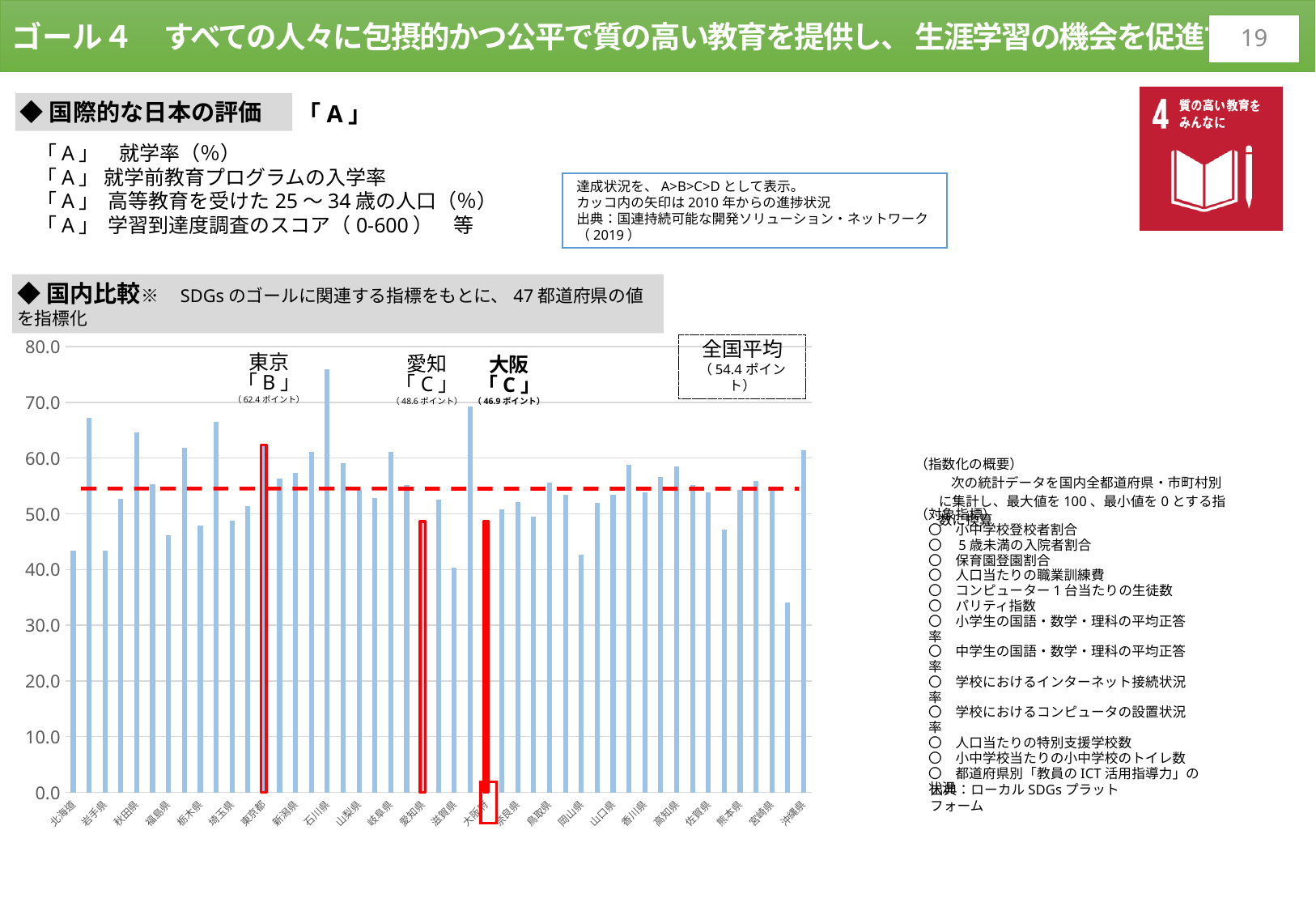
Which has the larger value, 愛知 or 大阪? 愛知 What kind of chart is used for the 国内比較? bar chart What rating is given to 東京 on the chart? B What is the value for 東京 in the 国内比較 bar chart? 62.4 ポイント Is the value for 東京 greater or less than 60.0? greater What is the 全国平均 (national average) shown on the chart? 54.4 ポイント By how much does 東京 exceed the 全国平均? 8.0 ポイント What is the difference between the values for 東京 and 大阪? 15.5 ポイント How many prefectures are compared in the 国内比較 chart? 47 What is the value for 大阪 in the 国内比較 bar chart? 46.9 ポイント What is the value for 愛知 in the 国内比較 bar chart? 48.6 ポイント Is the value for 大阪 greater or less than 50.0? less